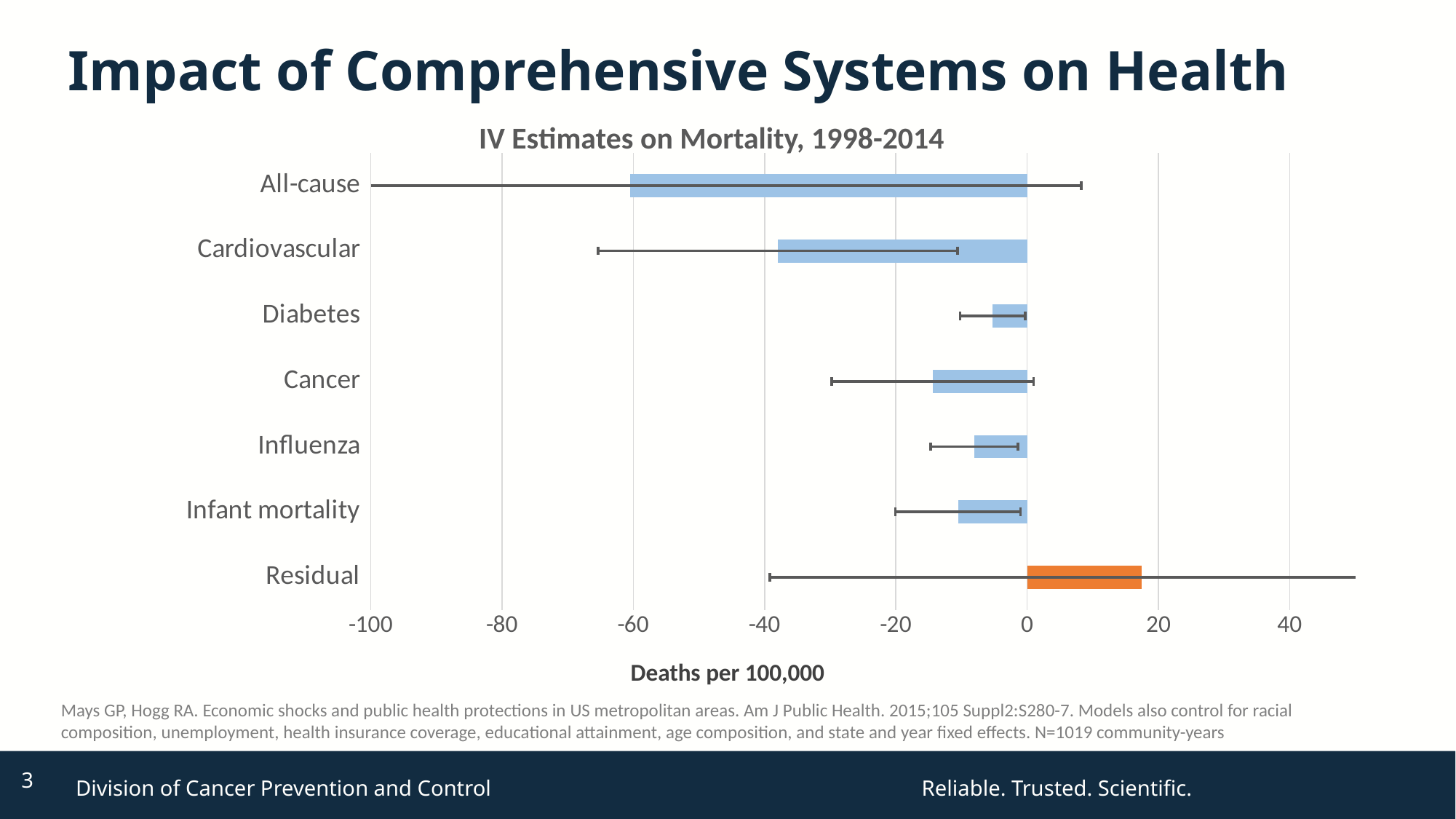
How many categories are plotted on the chart? 7 What is the title of the chart? IV Estimates on Mortality, 1998-2014 What kind of chart is shown on the slide? Bar chart Which has the lower value, Diabetes or Cancer? Cancer Is the value for All-cause greater or less than -40? less Which category has the lowest (most negative) value? All-cause Is the value for Cancer greater or less than -20? greater Is the value for Cardiovascular greater or less than -20? less Which category has the highest value? Residual What is the label of the horizontal axis? Deaths per 100,000 Which has the lower value, All-cause or Cardiovascular? All-cause